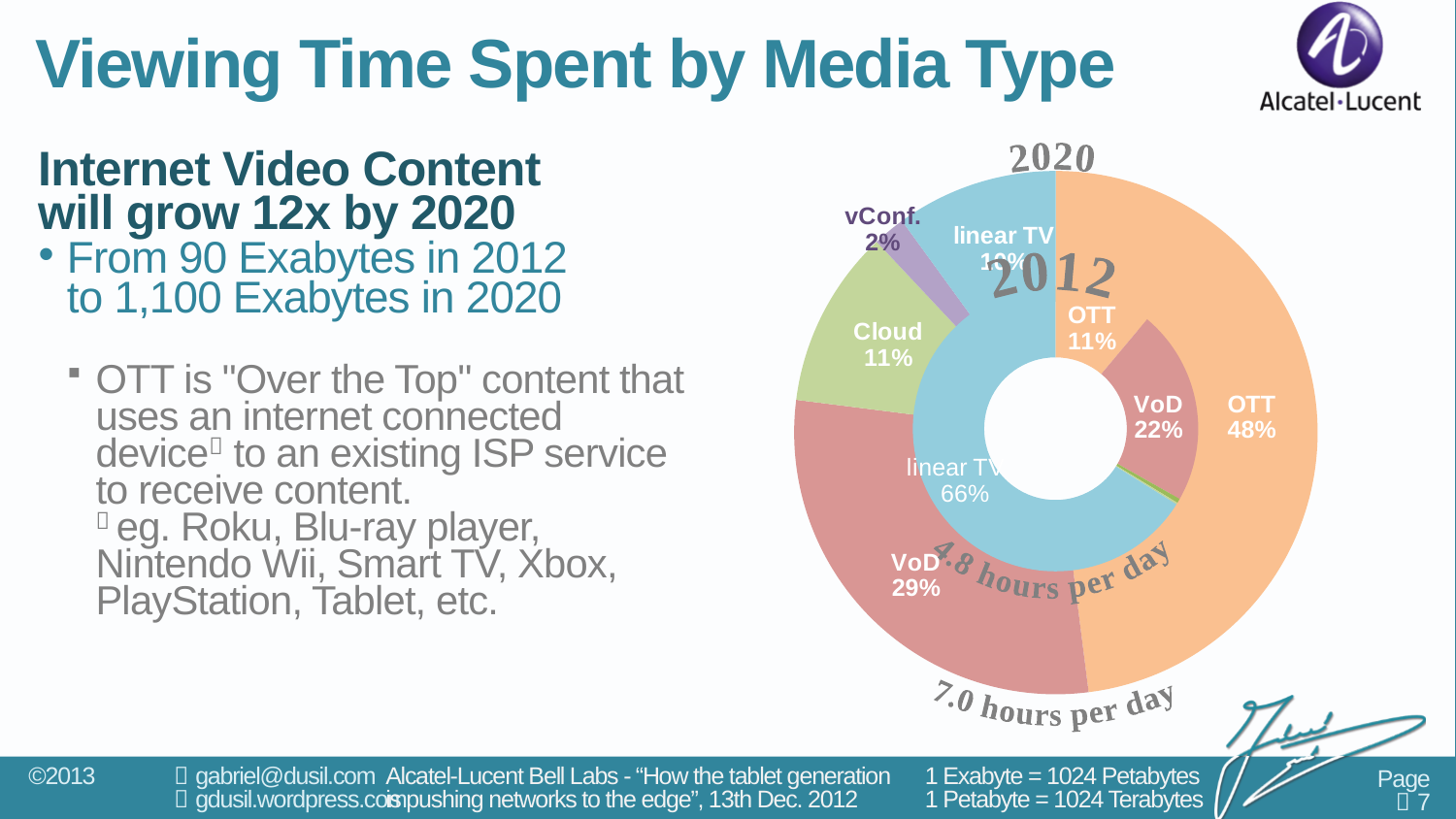
In the 2012 ring, what share of viewing time is VoD? 22% Which media type has the largest share in the 2012 ring? linear TV In the 2020 ring, what share of viewing time is VoD? 29% By how many percentage points does the OTT share in 2020 exceed the OTT share in 2012? 37 percentage points In the 2020 ring, what share of viewing time is vConf.? 2% In the 2012 ring, what share of viewing time is OTT? 11% In the 2012 ring, what share of viewing time is linear TV? 66% Which media type has the smallest share in the 2020 ring? vConf. In the 2020 ring, what share of viewing time is Cloud? 11% How many hours per day of viewing time are shown for 2020? 7.0 hours per day In the 2020 ring, what share of viewing time is OTT? 48% What kind of chart is shown on the slide? doughnut chart